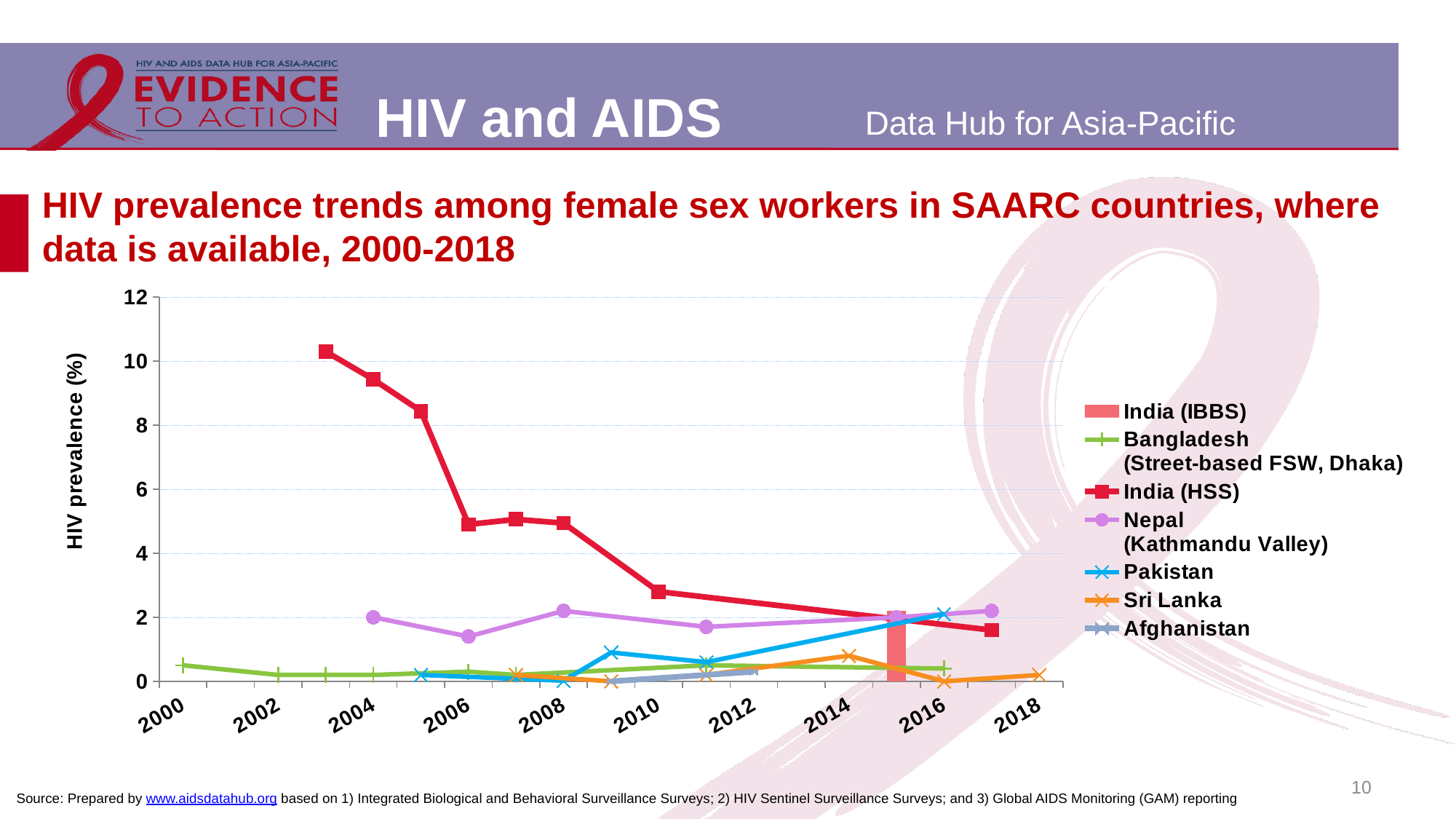
Does the India (HSS) series rise or fall from 2003 to 2017? fall Is the value for Bangladesh (Street-based FSW, Dhaka) in 2000 greater or less than 2? less How many series does the legend list? 7 Which legend entry is shown as a bar rather than a line? India (IBBS) Is the value for India (HSS) in 2003 greater or less than 8? greater Which series reaches the highest HIV prevalence value on the chart? India (HSS) Is the value for India (HSS) in 2017 greater or less than 2? less In 2006, which is higher: India (HSS) or Nepal (Kathmandu Valley)? India (HSS) What is the label on the y axis? HIV prevalence (%) What kind of chart is this? combination bar and line chart